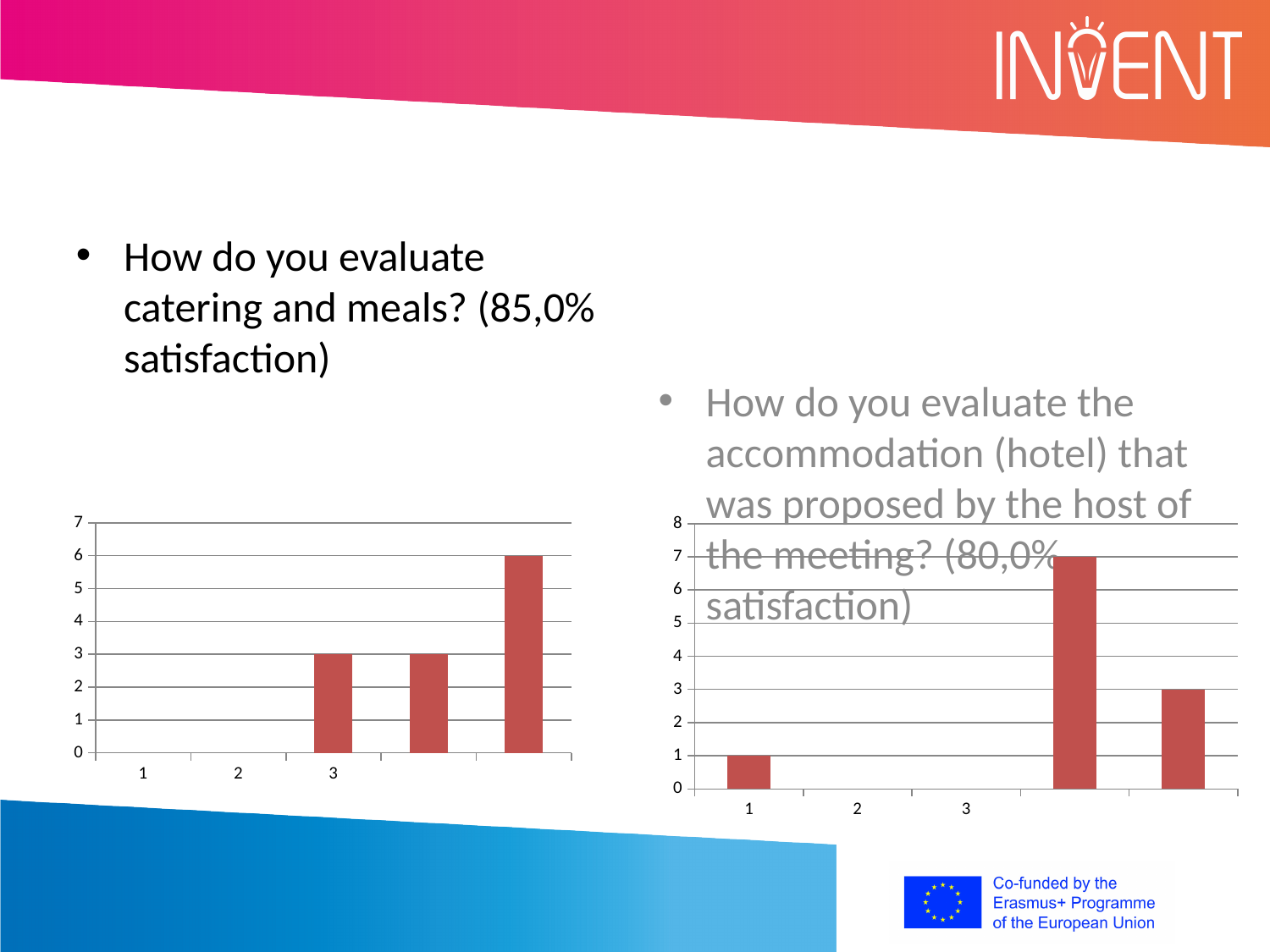
In the right chart, is the value of the tallest bar greater or less than 6? greater What kind of chart is the right chart? bar chart In the right chart, what is the value of the bar at category 1? 1 In the left chart, what is the value of the tallest bar? 6 In the right chart, what is the value of the shortest bar? 1 In the right chart, what is the difference between the tallest bar and the bar at category 1? 6 In the left chart, is the value of the bar at category 3 greater or less than 5? less How many bars are plotted in the left chart? 3 In the left chart, what is the value of the bar at category 3? 3 What colour are the bars in the left chart? red In the left chart, what is the difference between the tallest bar and the bar at category 3? 3 In the right chart, what is the value of the tallest bar? 7